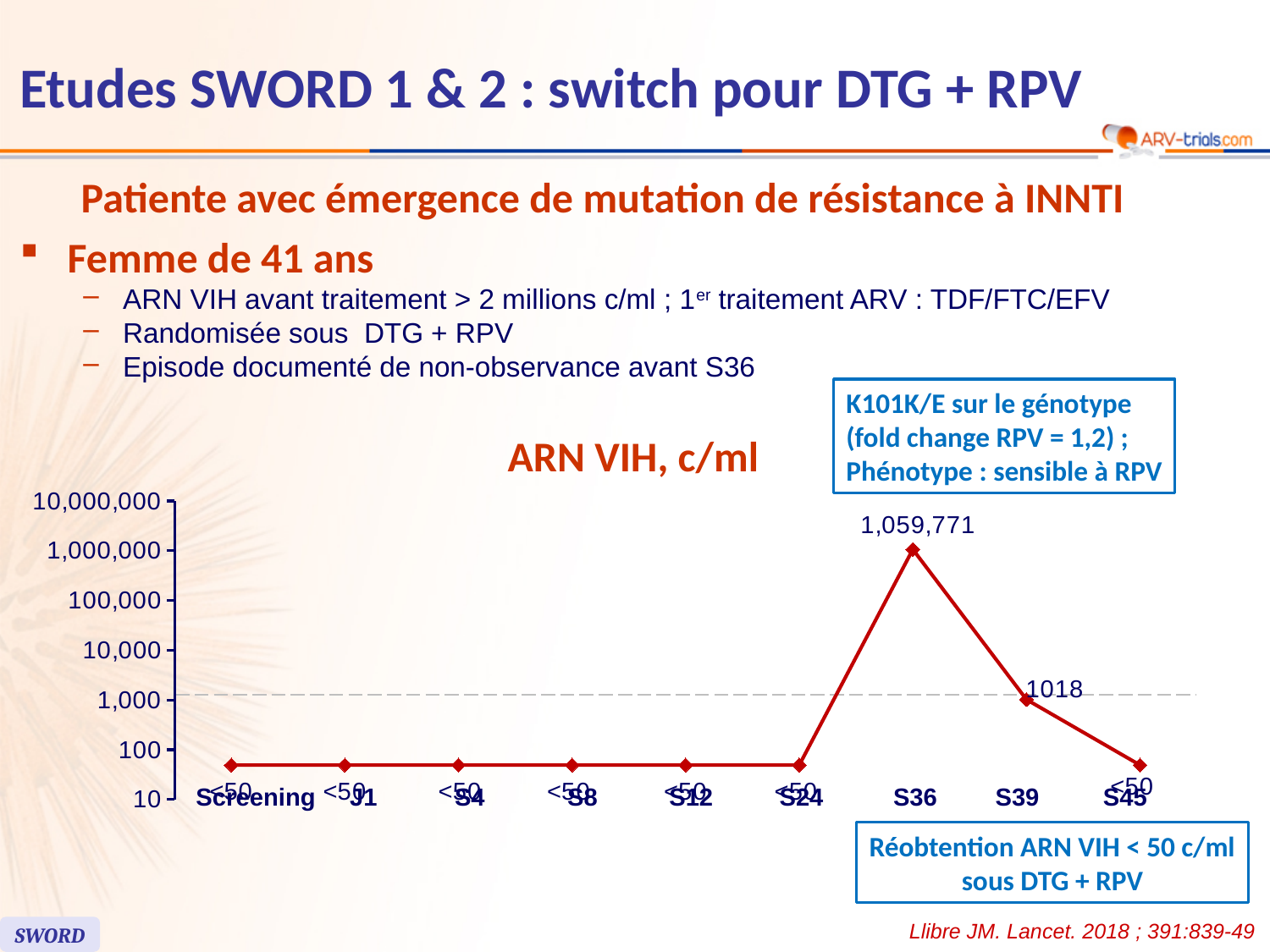
What is the difference between the ARN VIH values at S36 and S39? 1,058,753 What kind of chart is shown on the slide? line chart Do the ARN VIH values rise or fall from S36 to S45? fall Which is larger, the ARN VIH value at S36 or at S39? S36 Is the ARN VIH value at S39 greater or less than 10,000? less What is the ARN VIH value at S45? <50 How many time points are plotted on the x axis? 9 At which time point is the ARN VIH value highest? S36 What is the title of the chart? ARN VIH, c/ml Is the ARN VIH value at S36 greater or less than 1,000,000? greater What is the ARN VIH value at S39? 1018 What is the ARN VIH value at S36? 1,059,771